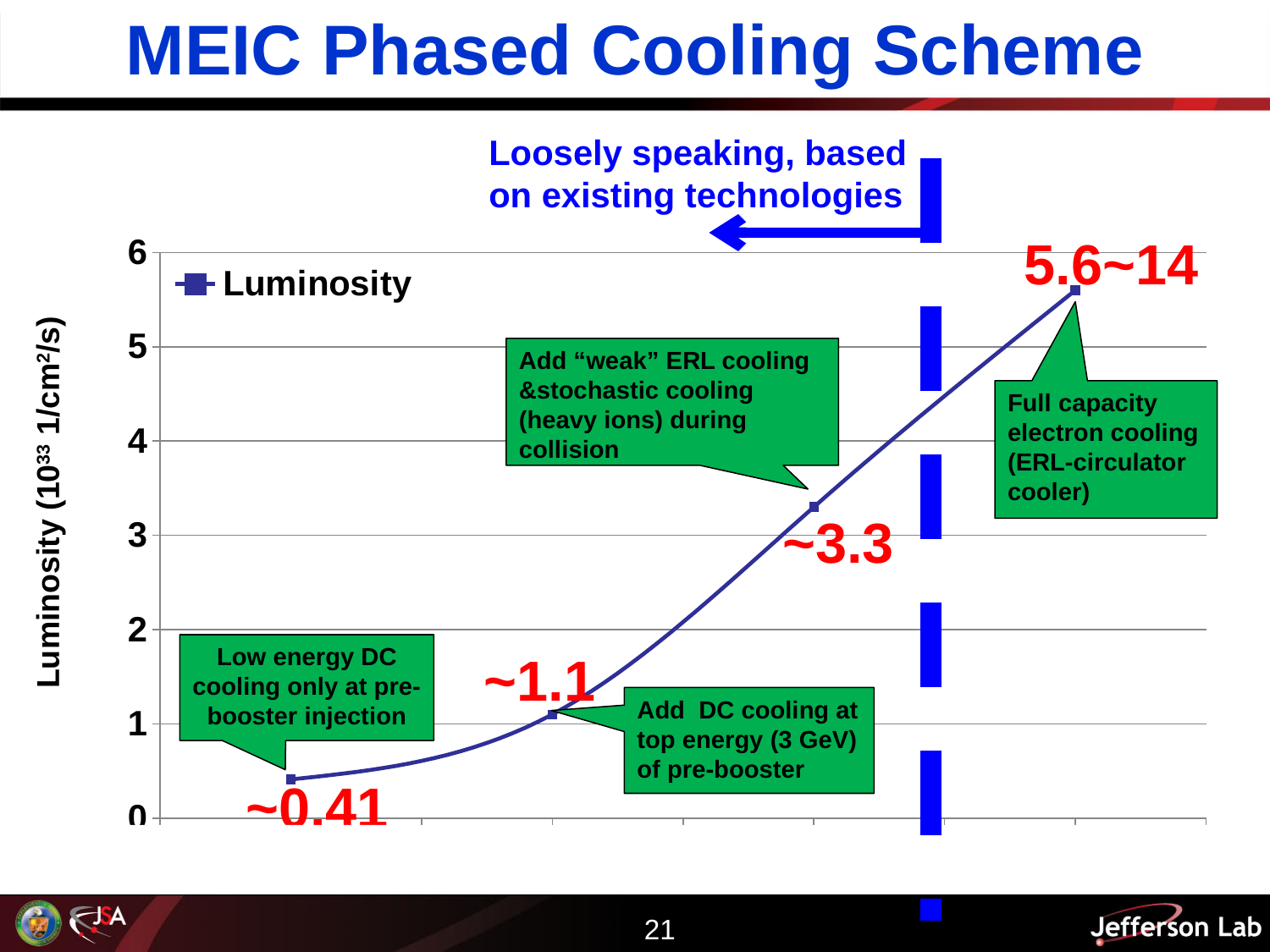
Is the luminosity value at the point annotated 'Low energy DC cooling only at pre-booster injection' greater or less than 1? less Is the luminosity value at the point annotated 'Add "weak" ERL cooling & stochastic cooling' greater or less than 3? greater Which cooling stage has the lowest plotted luminosity? Low energy DC cooling only at pre-booster injection What series name appears in the chart legend? Luminosity What is the label on the vertical axis of the chart? Luminosity (10^33 1/cm²/s) Is the luminosity value at the point annotated 'Full capacity electron cooling (ERL-circulator cooler)' greater or less than 5? greater How many series does the legend list? 1 Do the luminosity values rise or fall from left to right along the x axis? rise Which cooling stage has the highest plotted luminosity? Full capacity electron cooling (ERL-circulator cooler) What kind of chart is shown on the slide? line chart How many data points are plotted on the Luminosity line? 4